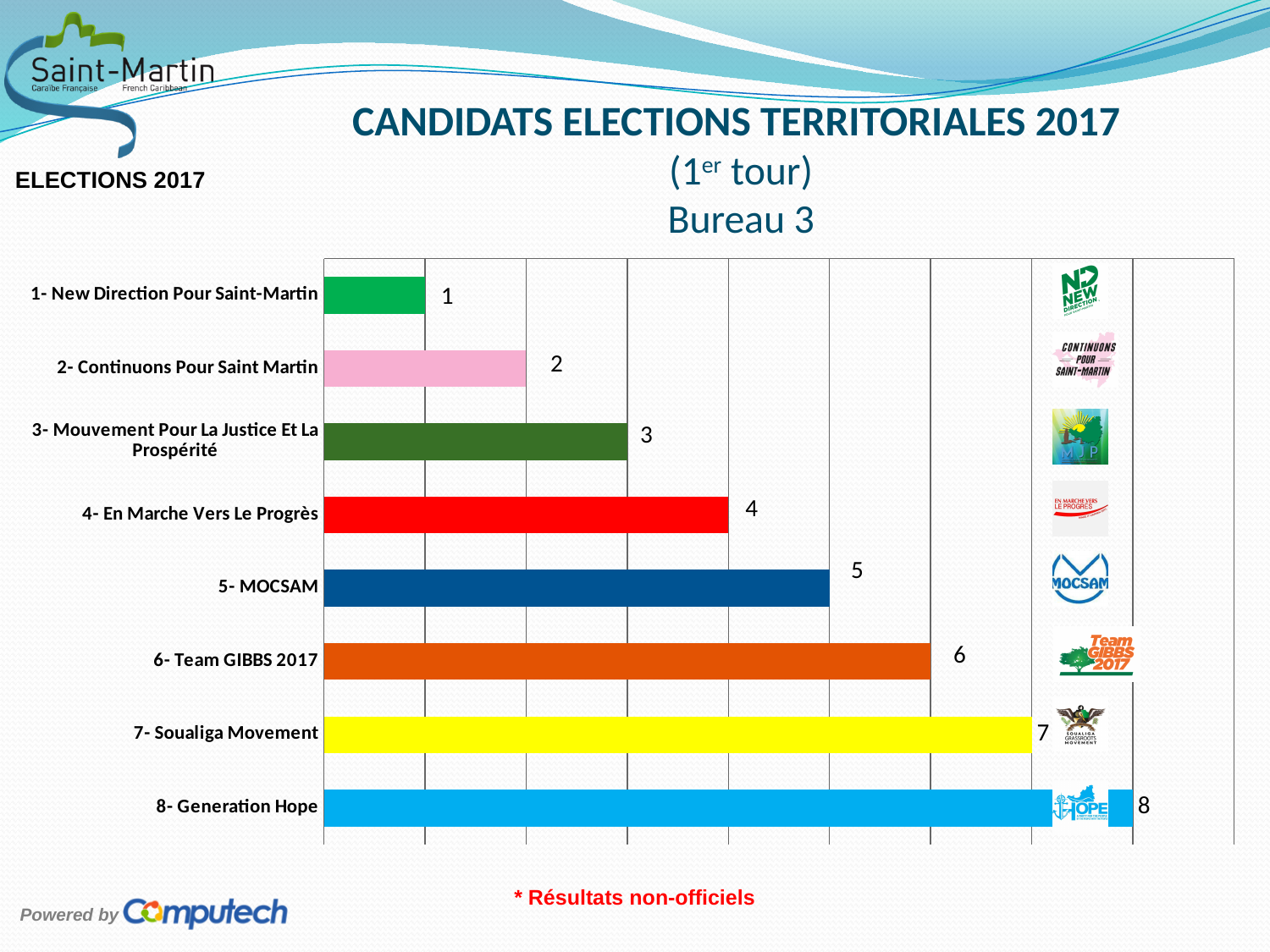
What is the title of the chart? CANDIDATS ELECTIONS TERRITORIALES 2017 (1er tour) Bureau 3 Which candidate list has the highest value in the chart? 8- Generation Hope What is the value shown for 2- Continuons Pour Saint Martin? 2 What colour is the bar for 4- En Marche Vers Le Progrès? red Which candidate list has the lowest value in the chart? 1- New Direction Pour Saint-Martin What kind of chart is shown on the slide? bar chart What is the difference between the values for 6- Team GIBBS 2017 and 3- Mouvement Pour La Justice Et La Prospérité? 3 What is the value shown for 7- Soualiga Movement? 7 Do the values increase or decrease going down the list of candidates from top to bottom? increase How many candidate lists are plotted in the chart? 8 Which has a larger value, 4- En Marche Vers Le Progrès or 2- Continuons Pour Saint Martin? 4- En Marche Vers Le Progrès What is the value shown for 5- MOCSAM? 5